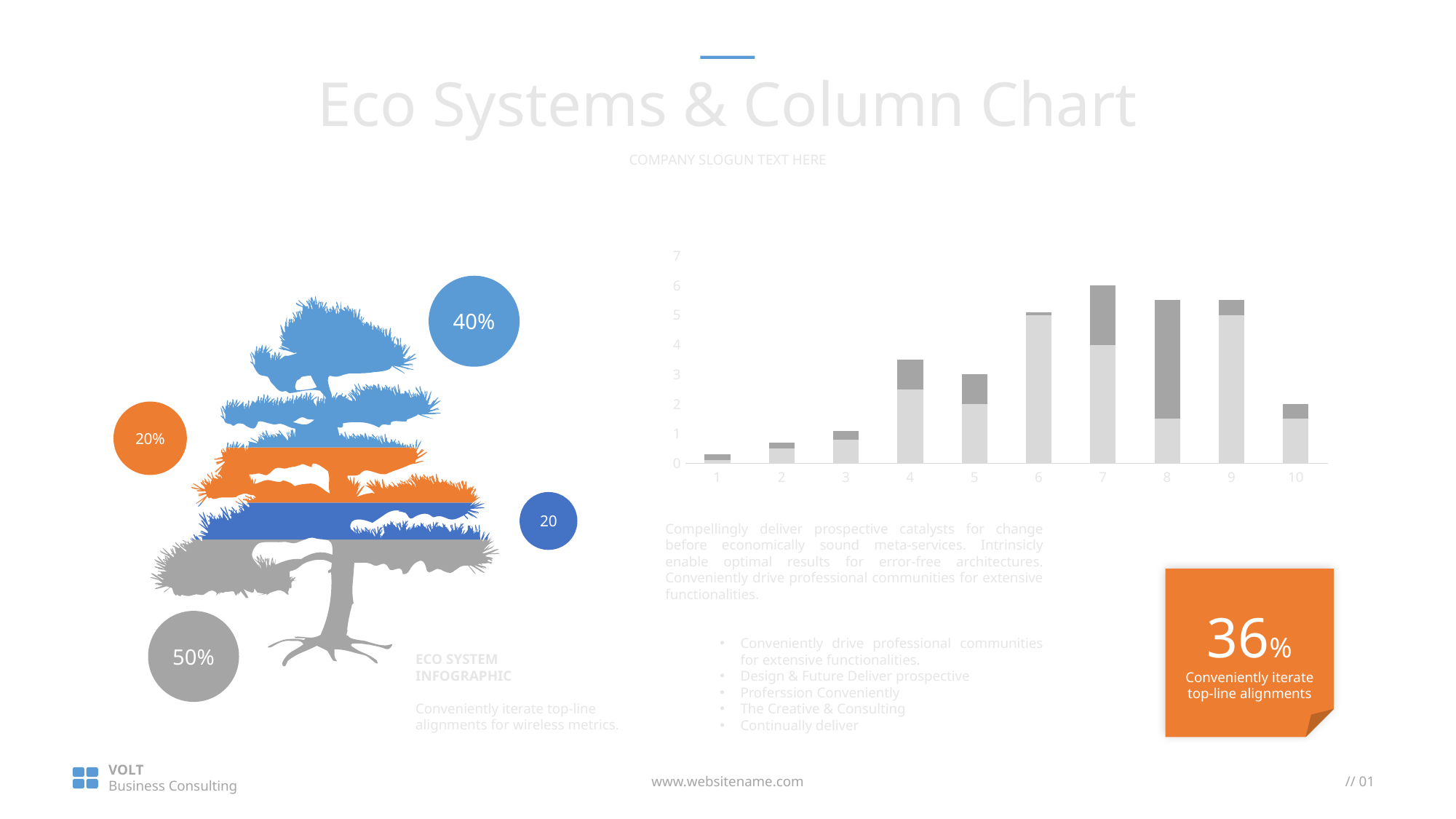
Is the total value for category 4 greater or less than 3? greater What kind of chart is shown on the slide? bar chart Which category has the shortest bar in the chart? 1 Do the bar totals rise or fall from category 1 to category 7? rise How many categories are shown on the x axis of the bar chart? 10 What is the total height of the stacked bar for category 5? 3 Which category has the tallest bar in the chart? 7 Which bar is taller, category 7 or category 10? 7 What is the total height of the stacked bar for category 7? 6 Is the total value for category 2 greater or less than 1? less What is the total height of the stacked bar for category 10? 2 What is the title of the slide containing the chart? Eco Systems & Column Chart